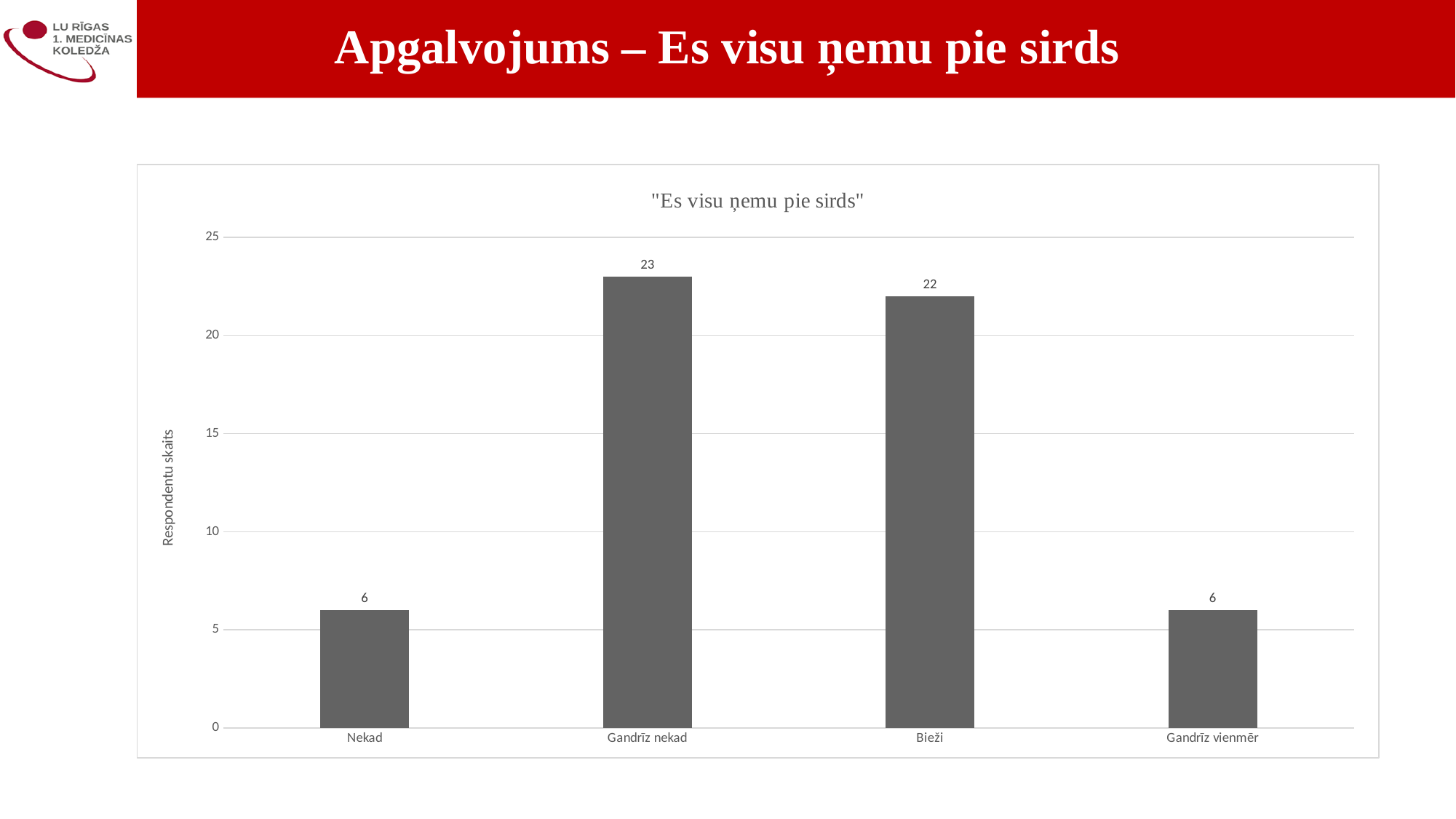
What is the difference between the values for Bieži and Nekad? 16 Is the value for Bieži greater or less than 20? greater What is the value for Gandrīz nekad? 23 What is the title of the chart? "Es visu ņemu pie sirds" Which category has the highest value? Gandrīz nekad What is the value for Bieži? 22 What is the value for Gandrīz vienmēr? 6 What kind of chart is shown? bar chart What is the difference between the values for Gandrīz nekad and Bieži? 1 Which is larger, the value for Gandrīz nekad or the value for Gandrīz vienmēr? Gandrīz nekad How many categories are shown on the x axis? 4 What is the value for Nekad? 6